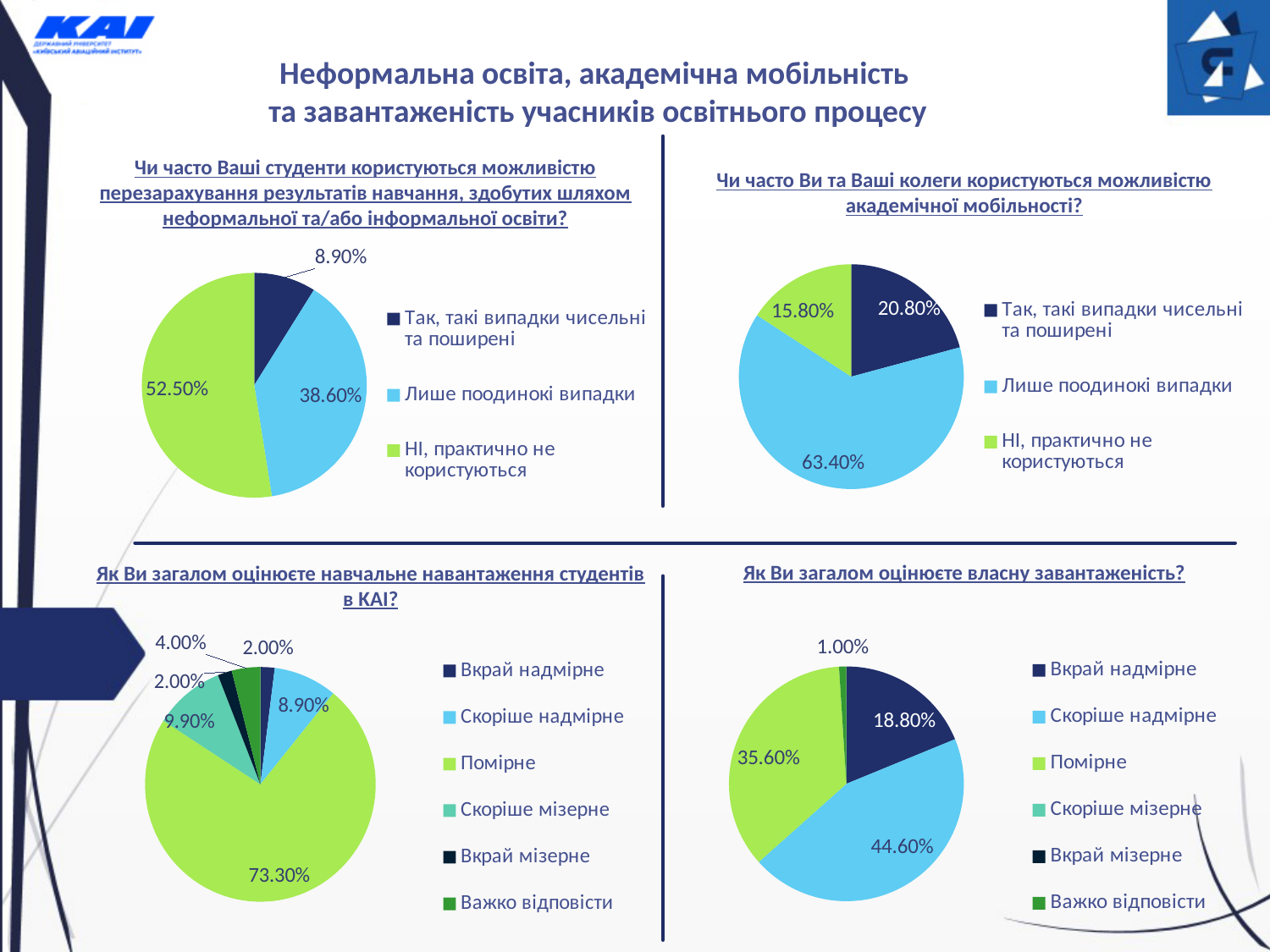
In the bottom-left chart, which is larger: 'Скоріше надмірне' or 'Скоріше мізерне'? Скоріше мізерне In the top-left chart, what share is 'Так, такі випадки чисельні та поширені'? 8.90% In the bottom-right chart, what is the difference between 'Скоріше надмірне' and 'Помірне'? 9.00% In the top-left chart, which category has the largest share? НІ, практично не користуються How many categories does the legend of the bottom-left chart list? 6 In the top-right chart, which category has the smallest share? НІ, практично не користуються What type of chart is used for the four charts on this slide? Pie chart In the chart 'Чи часто Ви та Ваші колеги користуються можливістю академічної мобільності?' (top right), what share is 'Лише поодинокі випадки'? 63.40% In the top-right chart, what is the difference between 'Так, такі випадки чисельні та поширені' and 'НІ, практично не користуються'? 5.00% In the chart 'Як Ви загалом оцінюєте власну завантаженість?' (bottom right), what share is 'Скоріше надмірне'? 44.60% In the chart 'Як Ви загалом оцінюєте навчальне навантаження студентів в КАІ?' (bottom left), what share is 'Помірне'? 73.30% In the chart 'Чи часто Ваші студенти користуються можливістю перезарахування результатів навчання...' (top left), what share is 'НІ, практично не користуються'? 52.50%